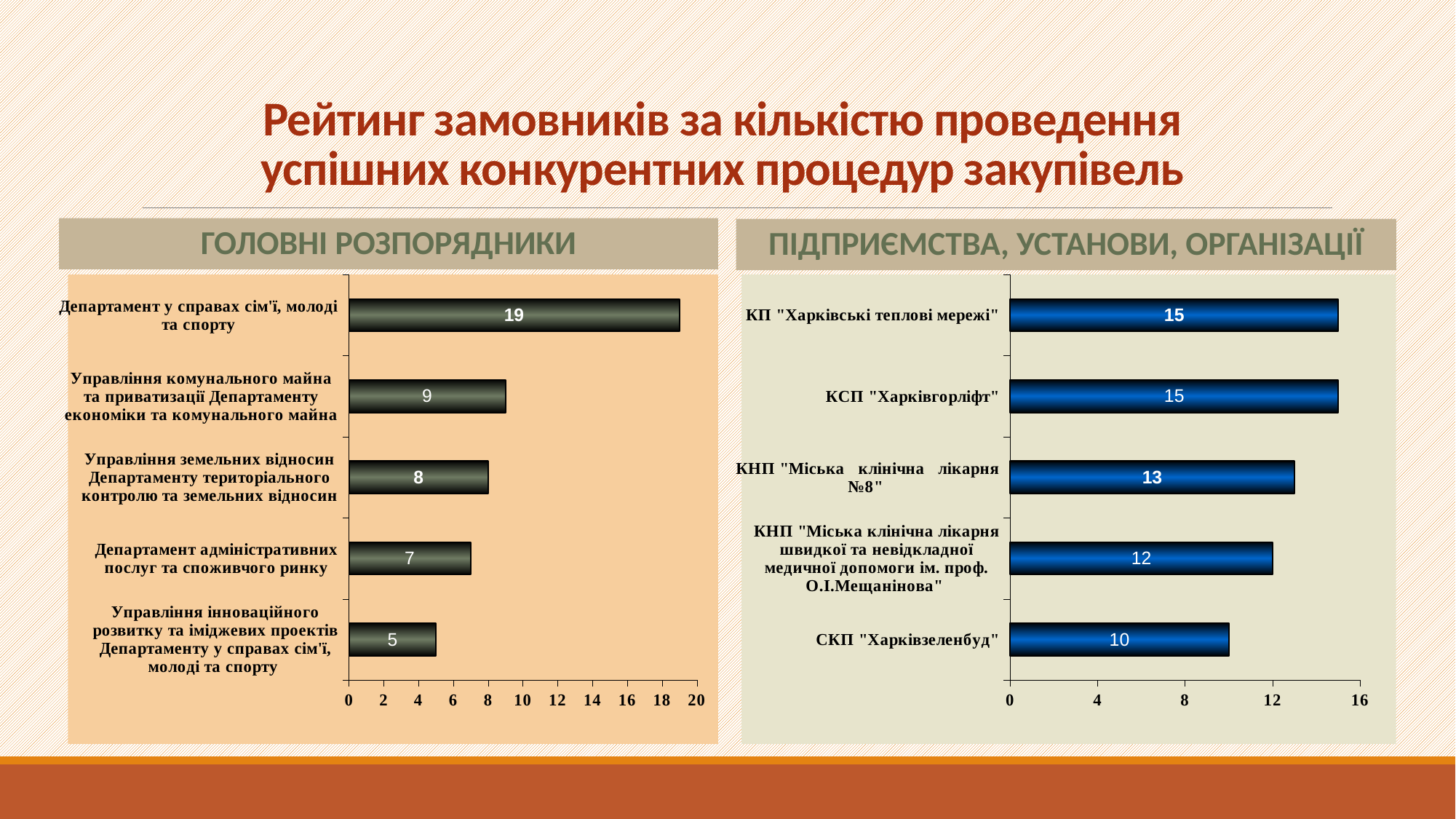
In the left chart (ГОЛОВНІ РОЗПОРЯДНИКИ), what is the value for Департамент адміністративних послуг та споживчого ринку? 7 In the left chart (ГОЛОВНІ РОЗПОРЯДНИКИ), how many categories are shown? 5 In the right chart (ПІДПРИЄМСТВА, УСТАНОВИ, ОРГАНІЗАЦІЇ), which is larger: the value for КП "Харківські теплові мережі" or the value for КНП "Міська клінічна лікарня швидкої та невідкладної медичної допомоги ім. проф. О.І.Мещанінова"? КП "Харківські теплові мережі" In the right chart (ПІДПРИЄМСТВА, УСТАНОВИ, ОРГАНІЗАЦІЇ), what is the maximum value shown on the horizontal axis? 16 In the right chart (ПІДПРИЄМСТВА, УСТАНОВИ, ОРГАНІЗАЦІЇ), what is the value for СКП "Харківзеленбуд"? 10 In the right chart (ПІДПРИЄМСТВА, УСТАНОВИ, ОРГАНІЗАЦІЇ), which category has the lowest value? СКП "Харківзеленбуд" In the left chart (ГОЛОВНІ РОЗПОРЯДНИКИ), what is the value for Департамент у справах сім'ї, молоді та спорту? 19 In the left chart (ГОЛОВНІ РОЗПОРЯДНИКИ), which category has the lowest value? Управління інноваційного розвитку та іміджевих проектів Департаменту у справах сім'ї, молоді та спорту In the right chart (ПІДПРИЄМСТВА, УСТАНОВИ, ОРГАНІЗАЦІЇ), what is the value for КНП "Міська клінічна лікарня №8"? 13 In the right chart (ПІДПРИЄМСТВА, УСТАНОВИ, ОРГАНІЗАЦІЇ), what is the difference between the values for КСП "Харківгорліфт" and СКП "Харківзеленбуд"? 5 In the left chart (ГОЛОВНІ РОЗПОРЯДНИКИ), what kind of chart is it? Bar chart In the left chart (ГОЛОВНІ РОЗПОРЯДНИКИ), what is the difference between the values for Департамент у справах сім'ї, молоді та спорту and Управління комунального майна та приватизації Департаменту економіки та комунального майна? 10